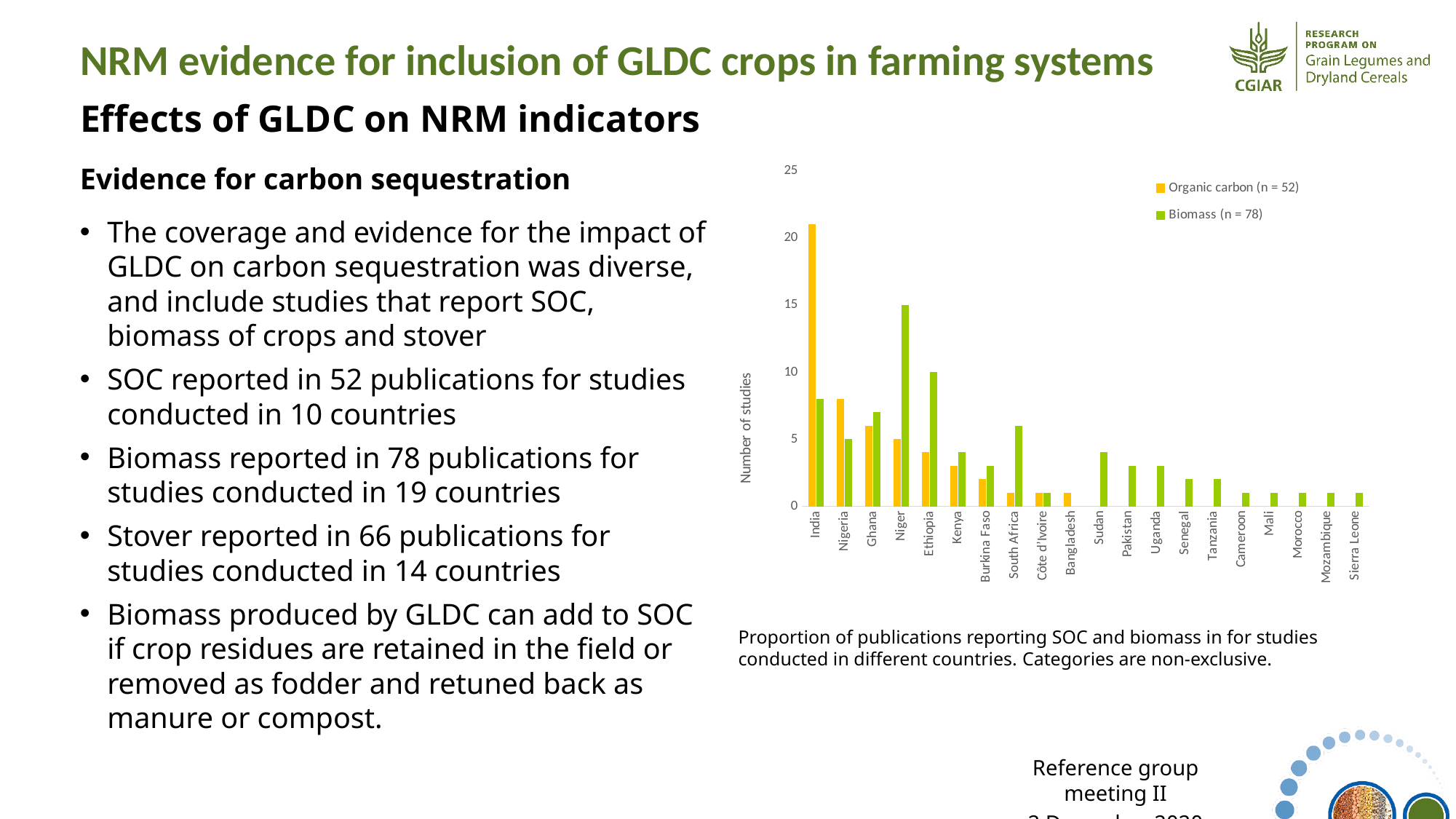
How many countries are shown on the x axis of the chart? 20 What is the full legend entry for the green series? Biomass (n = 78) What is the label of the y axis of the chart? Number of studies Is the Biomass value for Sudan greater or less than 5? less Is the Organic carbon value for India greater or less than 20? greater Which is larger for India, the Organic carbon value or the Biomass value? Organic carbon What kind of chart is shown on the slide? bar chart How many series does the chart legend list? 2 Which is larger for Niger, the Organic carbon value or the Biomass value? Biomass Which country has the highest Biomass value? Niger Which country has the highest Organic carbon value? India Is the Biomass value for South Africa greater or less than 5? greater